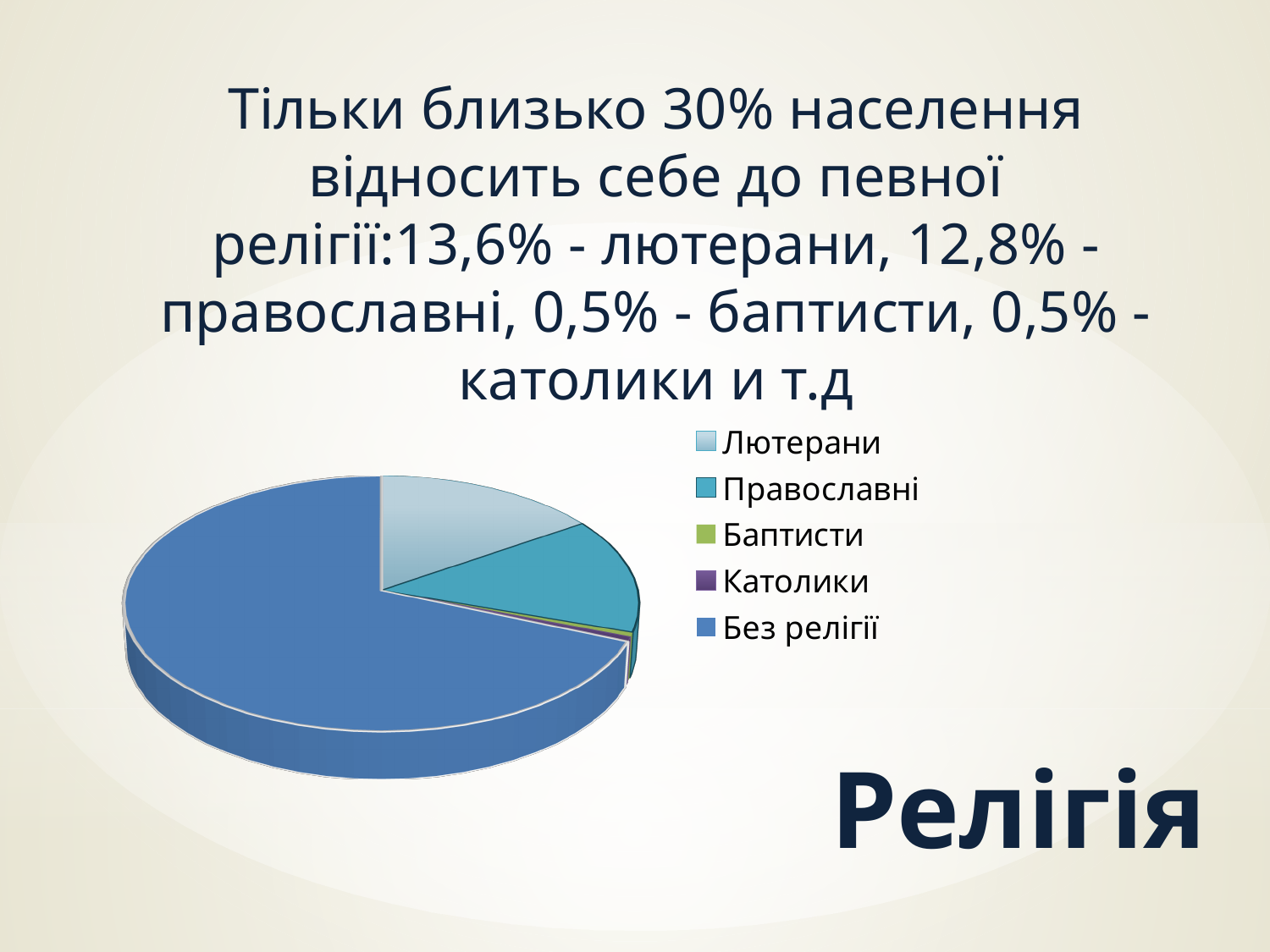
What kind of chart is shown on the slide? pie chart According to the slide, what share of the population are Православні? 12,8% Is the slice for Без релігії greater or less than half of the pie? greater Which category has the largest slice of the pie chart? Без релігії According to the slide, what share of the population are Баптисти? 0,5% According to the slide, what share of the population are Лютерани? 13,6% What is the large heading in the bottom-right corner of the slide? Релігія According to the slide, what share of the population are Католики? 0,5% Which legend entry is listed first in the pie chart's legend? Лютерани Which is larger, the share of Лютерани or the share of Православні? Лютерани How many categories does the pie chart's legend list? 5 What is the difference between the shares of Лютерани and Православні? 0,8%